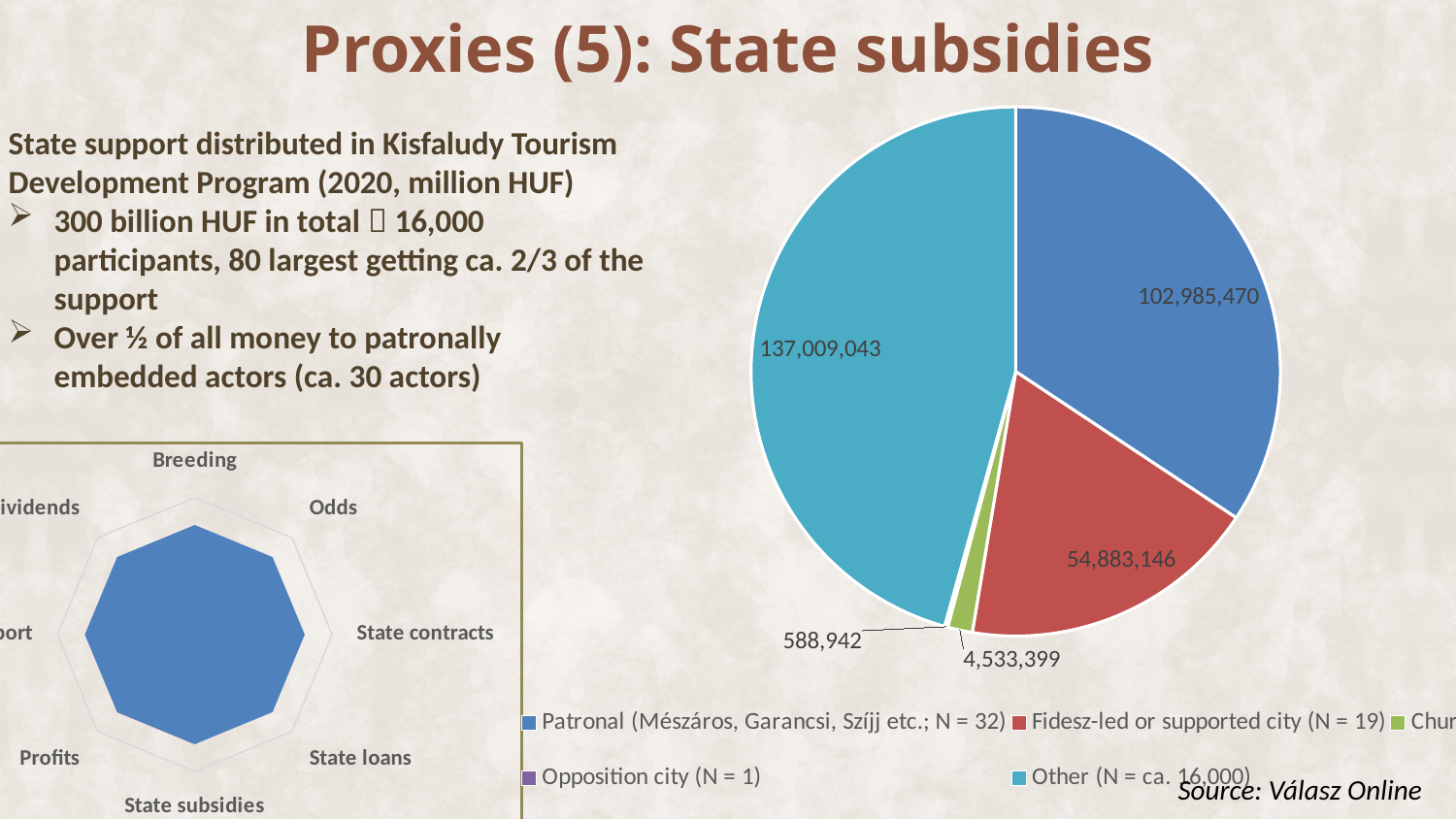
In the pie chart, what is the difference between the Other slice and the Patronal slice? 34,023,573 In the pie chart, which is larger: the Patronal slice or the Fidesz-led or supported city slice? Patronal How many slices does the pie chart have? 5 In the pie chart, which category has the largest slice? Other (N = ca. 16,000) In the pie chart, what share of the total does the Patronal slice represent? 34.3% In the pie chart, what value is shown for the Fidesz-led or supported city (N = 19) slice? 54,883,146 In the pie chart, what value is shown for the Opposition city (N = 1) slice? 588,942 In the pie chart, what value is shown for the Patronal (Mészáros, Garancsi, Szíjj etc.; N = 32) slice? 102,985,470 What kind of chart is the chart on the right side of the slide? Pie chart In the pie chart, which category has the smallest slice? Opposition city (N = 1) What kind of chart is shown in the bottom-left corner of the slide? Radar chart In the pie chart, what value is shown for the Other (N = ca. 16,000) slice? 137,009,043